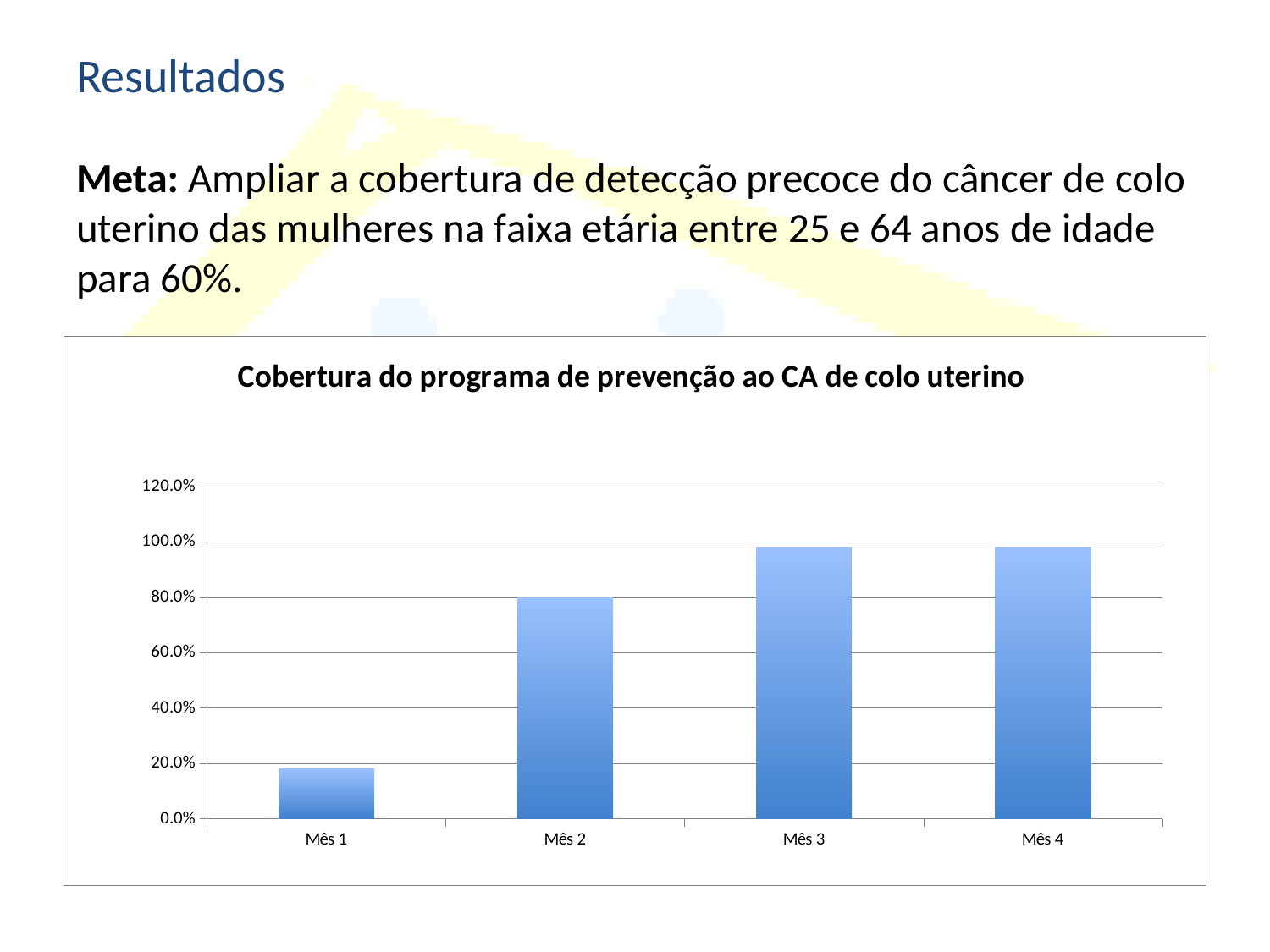
Which month has the lowest coverage value in the chart? Mês 1 Is the value for Mês 3 greater or less than 80.0%? greater Is the value for Mês 2 greater or less than 60.0%? greater Which is larger, the value for Mês 2 or the value for Mês 3? Mês 3 Do the coverage values generally rise or fall from Mês 1 to Mês 4? rise What kind of chart is shown on the slide? bar chart What is the highest value shown on the y axis of the chart? 120.0% How many categories (months) are shown on the x axis of the chart? 4 Which is larger, the value for Mês 1 or the value for Mês 2? Mês 2 What is the title of the chart? Cobertura do programa de prevenção ao CA de colo uterino Is the value for Mês 1 greater or less than 20.0%? less